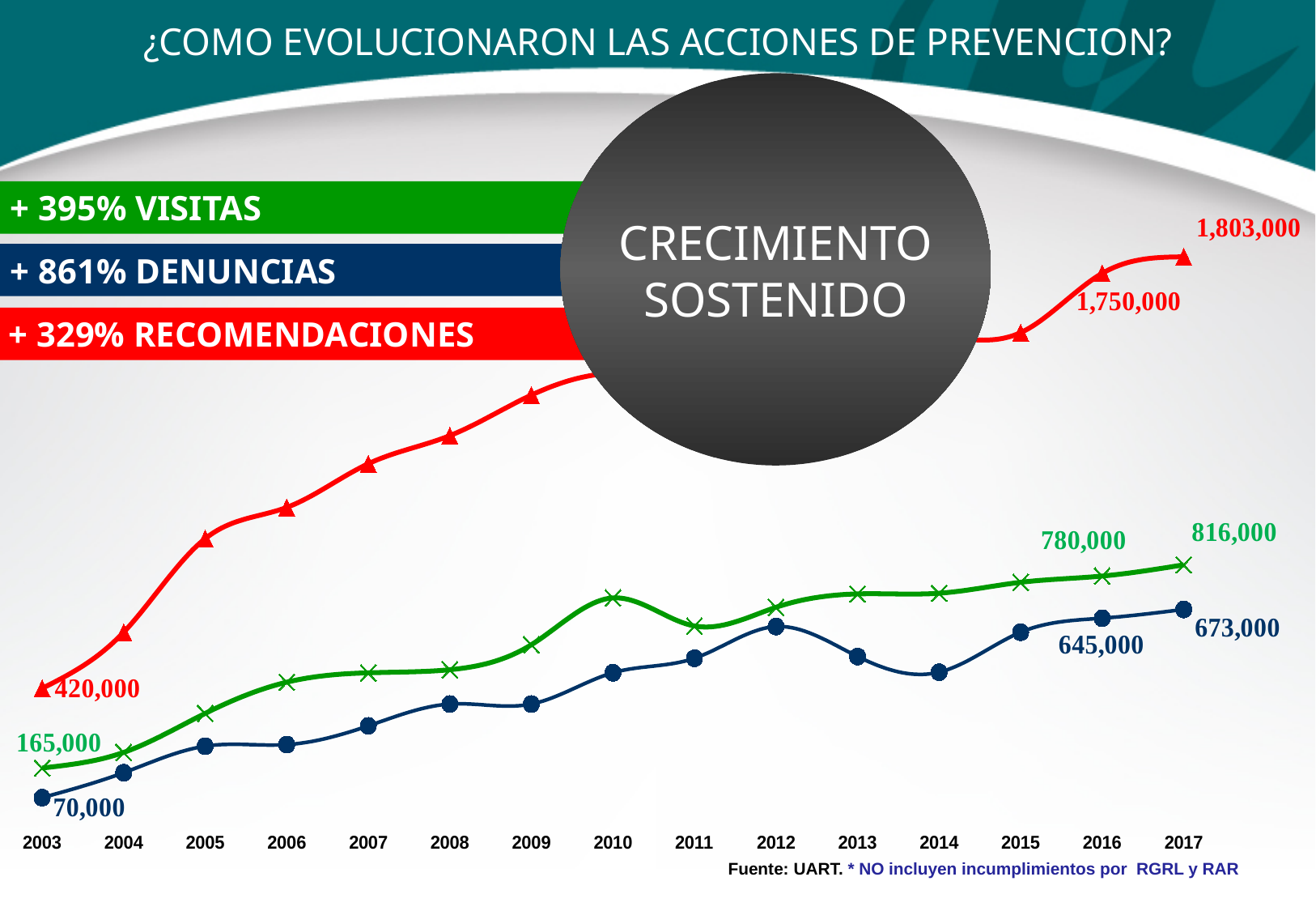
By how much did the red Recomendaciones line increase from 2016 to 2017? 53,000 Which of the three lines has the highest value in 2017? Recomendaciones (red) What type of chart is shown on the slide? line chart Which of the three lines has the lowest value in 2003? Denuncias (blue) What is the value of the green Visitas line in 2003? 165,000 What is the value of the blue Denuncias line in 2016? 645,000 What is the value of the red Recomendaciones line in 2003? 420,000 What is the value of the red Recomendaciones line in 2017? 1,803,000 What is the value of the blue Denuncias line in 2003? 70,000 How many years are shown on the x axis of the chart? 15 Does the green Visitas line generally rise or fall from 2003 to 2017? rise What is the difference between the green Visitas value and the blue Denuncias value in 2017? 143,000